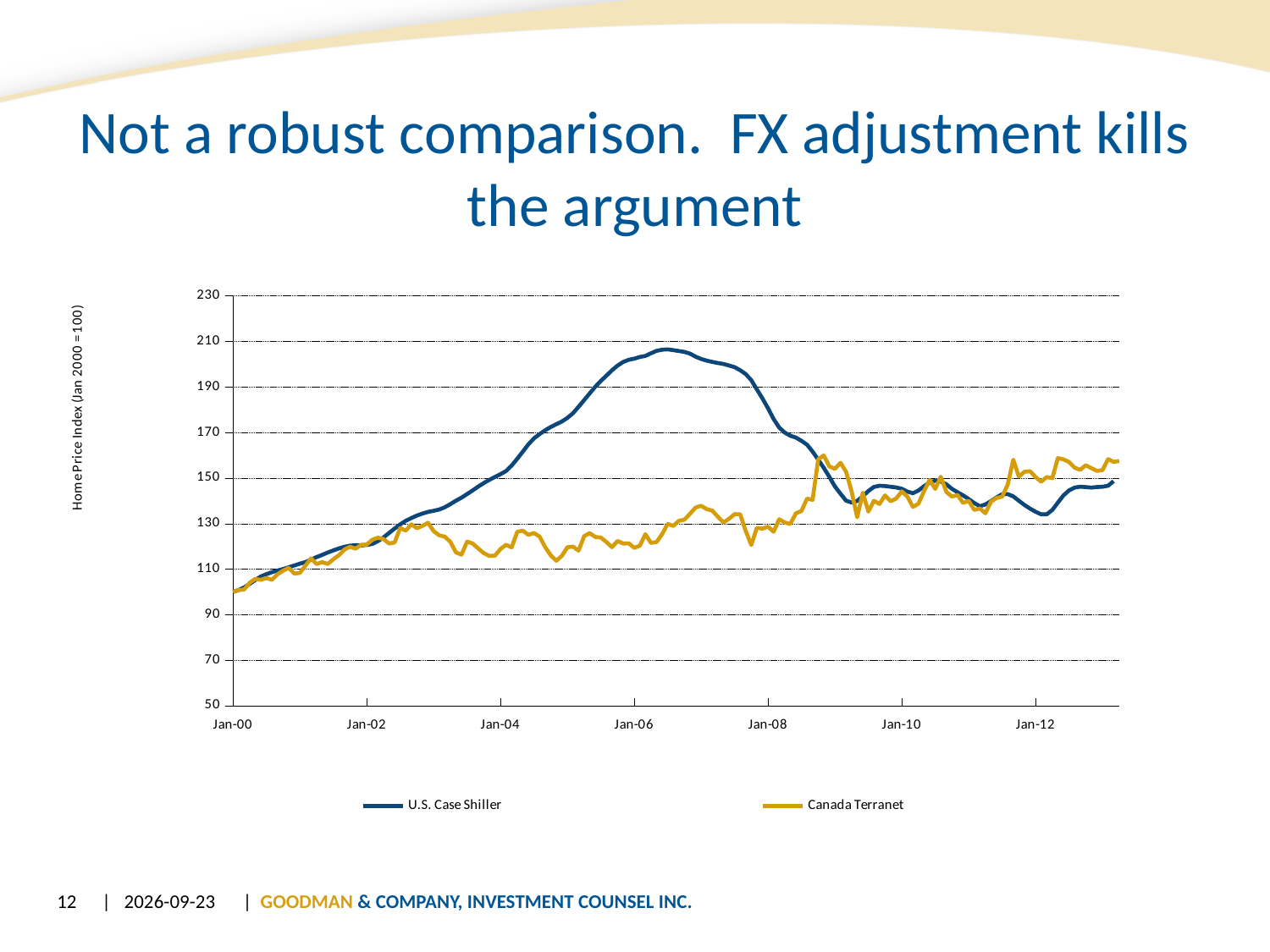
Is the value of U.S. Case Shiller at Jan-12 greater or less than 150? less How many series does the legend list? 2 What is the label on the vertical axis? Home Price Index (Jan 2000 = 100) What kind of chart is shown on the slide? line chart Does the U.S. Case Shiller series rise or fall between Jan-06 and Jan-08? fall Which series reaches the highest value anywhere on the chart? U.S. Case Shiller At Jan-06, which series has the higher value, U.S. Case Shiller or Canada Terranet? U.S. Case Shiller Is the value of Canada Terranet at Jan-06 greater or less than 130? less Is the peak value of the U.S. Case Shiller series greater or less than 190? greater At Jan-12, which series has the higher value, U.S. Case Shiller or Canada Terranet? Canada Terranet What are the two series named in the legend? U.S. Case Shiller and Canada Terranet